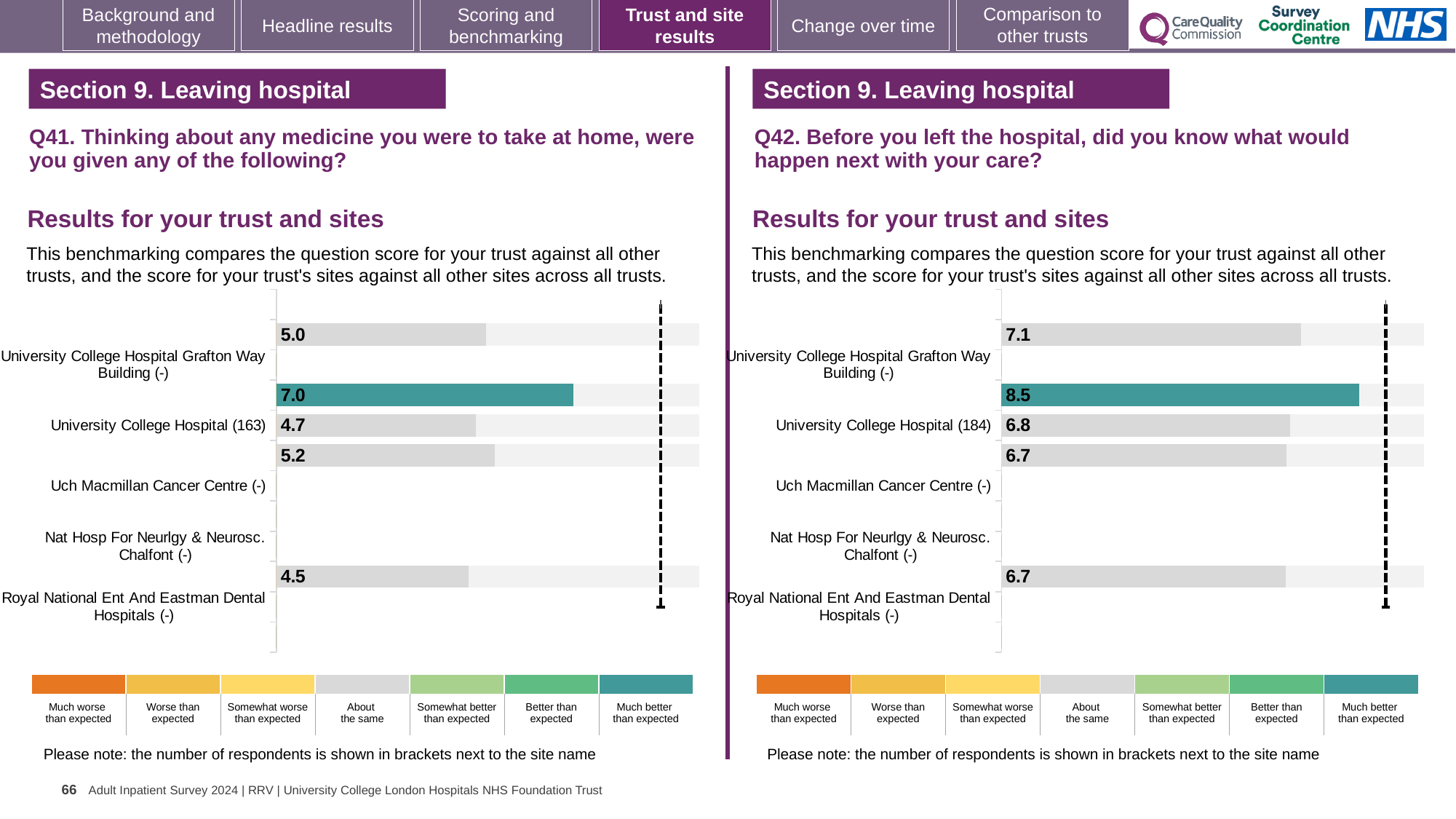
On the right chart (Q42), what is the highest value printed on any bar? 8.5 On the left chart (Q41), what is the highest value printed on any bar? 7.0 On the left chart (Q41), what is the lowest value printed on any bar? 4.5 On the right chart (Q42), what is the difference between the highest printed value (8.5) and the lowest printed value (6.7)? 1.8 On the right chart (Q42), what is the lowest value printed on any bar? 6.7 What kind of chart is used on the left (Q41) side of the slide? Bar chart How many site names are listed down the left side of the Q41 chart? 5 On the right chart (Q42), how many respondents are shown in brackets for University College Hospital? 184 On the left chart (Q41), what is the difference between the highest printed value (7.0) and the lowest printed value (4.5)? 2.5 Which chart has the higher top bar value, the left chart (Q41) or the right chart (Q42)? The right chart (Q42) How many rating categories does the colour key below the Q42 chart show? 7 On the left chart (Q41), how many respondents are shown in brackets for University College Hospital? 163